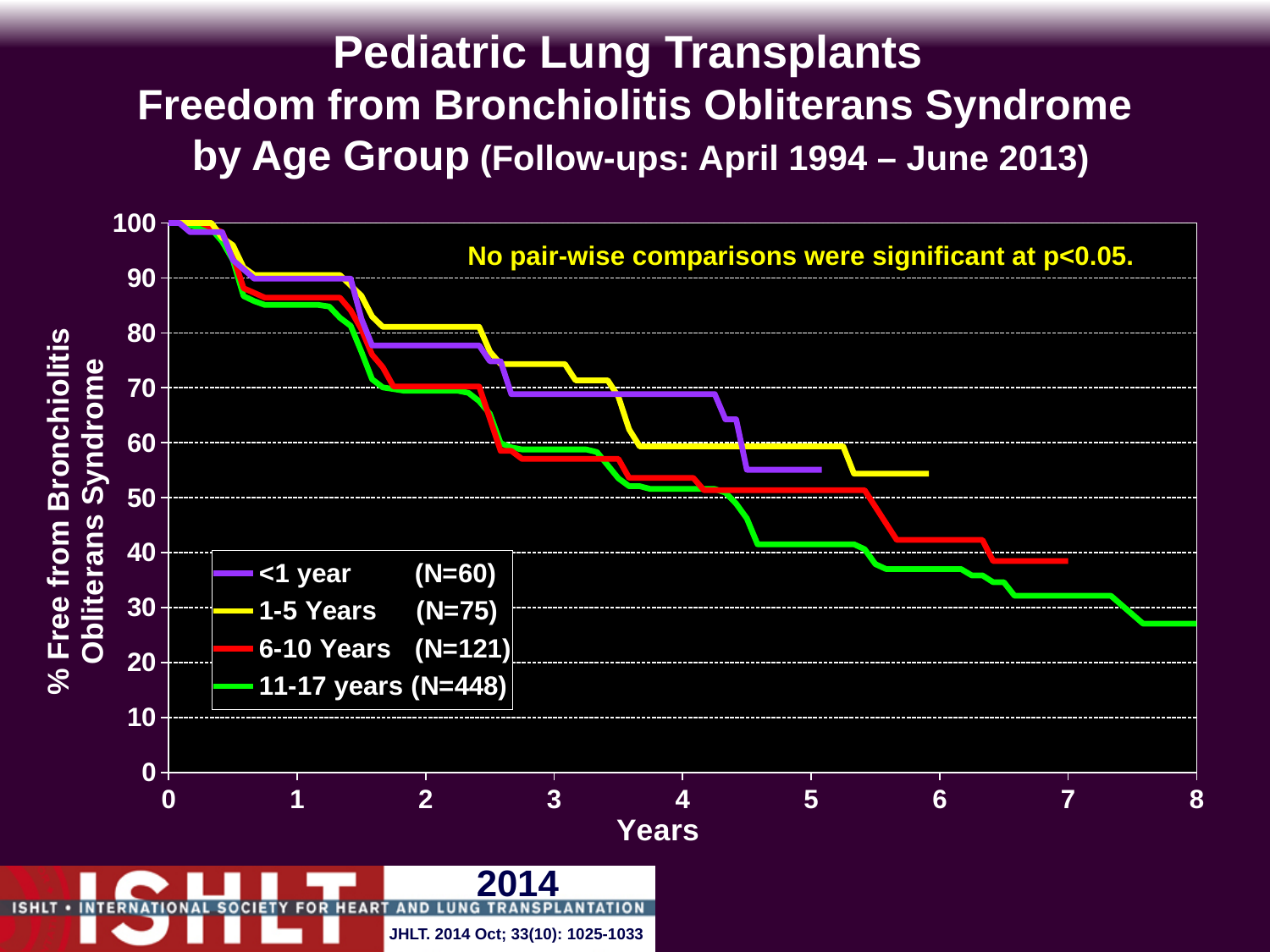
Which age group has the smallest N in the legend? <1 year What is the label of the x axis? Years Is the value for the 1-5 Years group at 3 years greater or less than 70? greater Do the curves rise or fall as years since transplant increase? Fall How many series does the legend list? 4 At 6 years, which group has the higher value: 6-10 Years or 11-17 years? 6-10 Years What is the N for the <1 year group shown in the legend? N=60 Which age group has the largest N in the legend? 11-17 years What is the N for the 11-17 years group shown in the legend? N=448 What kind of chart is shown on the slide? Line chart Is the value for the 11-17 years group at 8 years greater or less than 30? less Is the value for the <1 year group at 2 years greater or less than 80? less